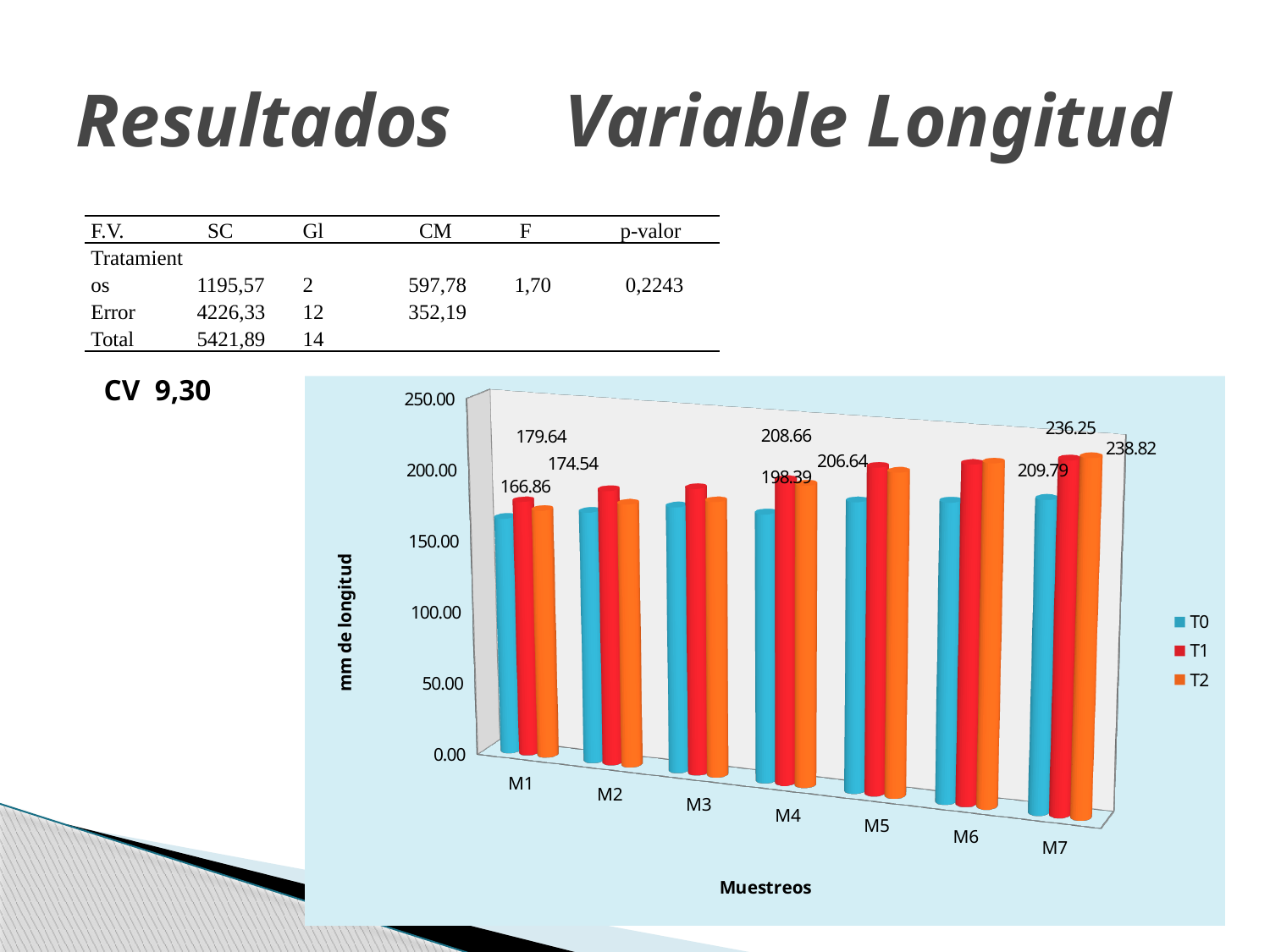
Is the value for T0 at M2 greater or less than 200.00? less What is the value for T2 at M7? 238.82 Do the T0 values rise or fall from M1 to M7? Rise How many series does the legend list? 3 What is the value for T0 at M1? 166.86 At M1, which series has the larger value, T1 or T2? T1 What is the difference between the T2 and T0 values at M7? 29.03 How many samplings (categories) are shown on the x axis? 7 What is the value for T1 at M7? 236.25 Which sampling (M1 to M7) has the highest T2 value? M7 What kind of chart is shown on the slide? Bar chart What is the value for T1 at M4? 208.66